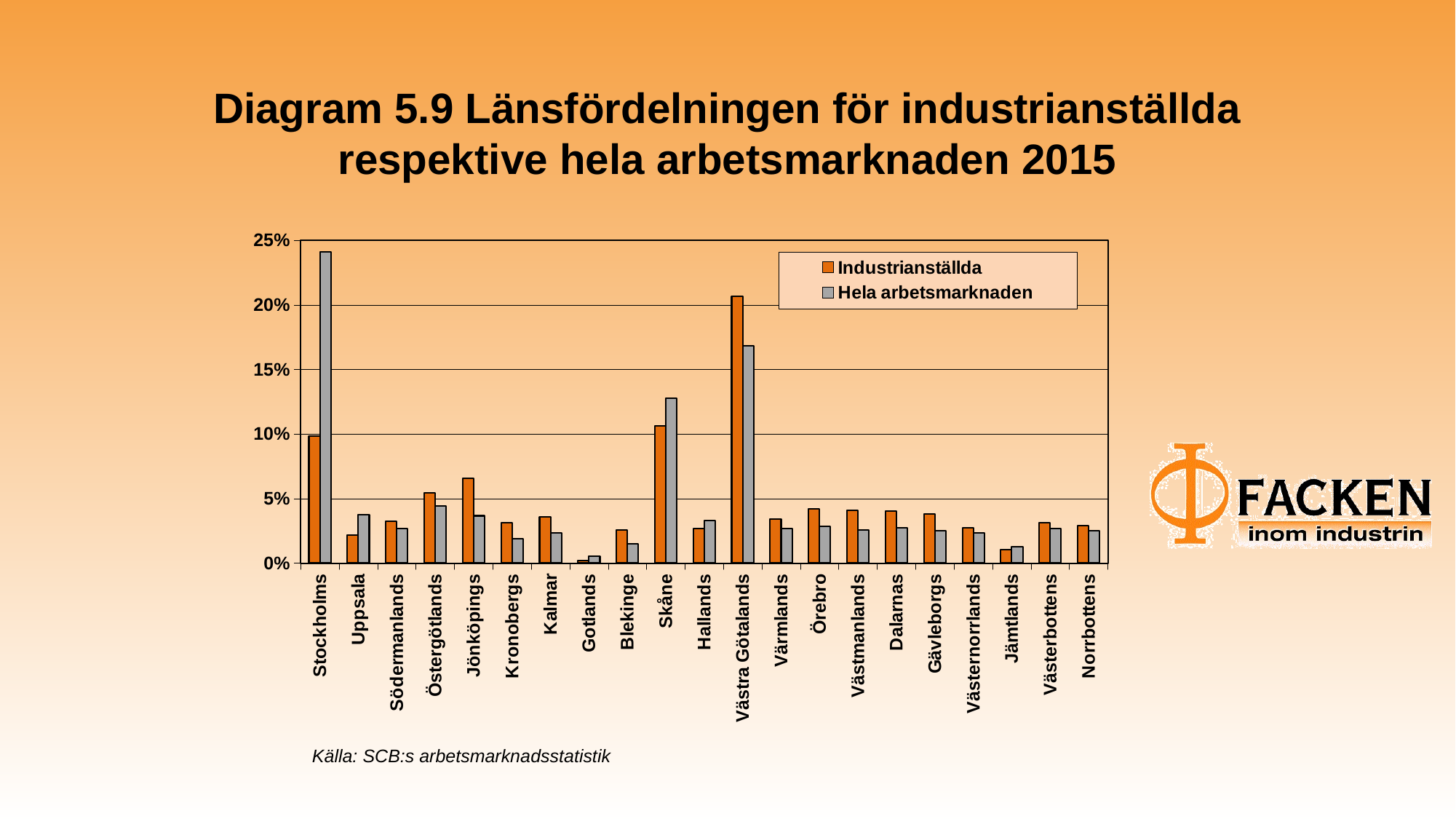
Is the Hela arbetsmarknaden value for Skåne greater or less than 10%? greater For Jönköpings, which series has the larger value, Industrianställda or Hela arbetsmarknaden? Industrianställda Is the Industrianställda value for Västra Götalands greater or less than 20%? greater How many counties (categories) are shown on the x axis? 21 Which county has the highest value for Industrianställda? Västra Götalands How many series does the legend list? 2 For Stockholms, which series has the larger value, Industrianställda or Hela arbetsmarknaden? Hela arbetsmarknaden Which county has the lowest value for Industrianställda? Gotlands Is the Industrianställda value for Uppsala greater or less than 5%? less What kind of chart is shown on the slide? bar chart Which county has the highest value for Hela arbetsmarknaden? Stockholms